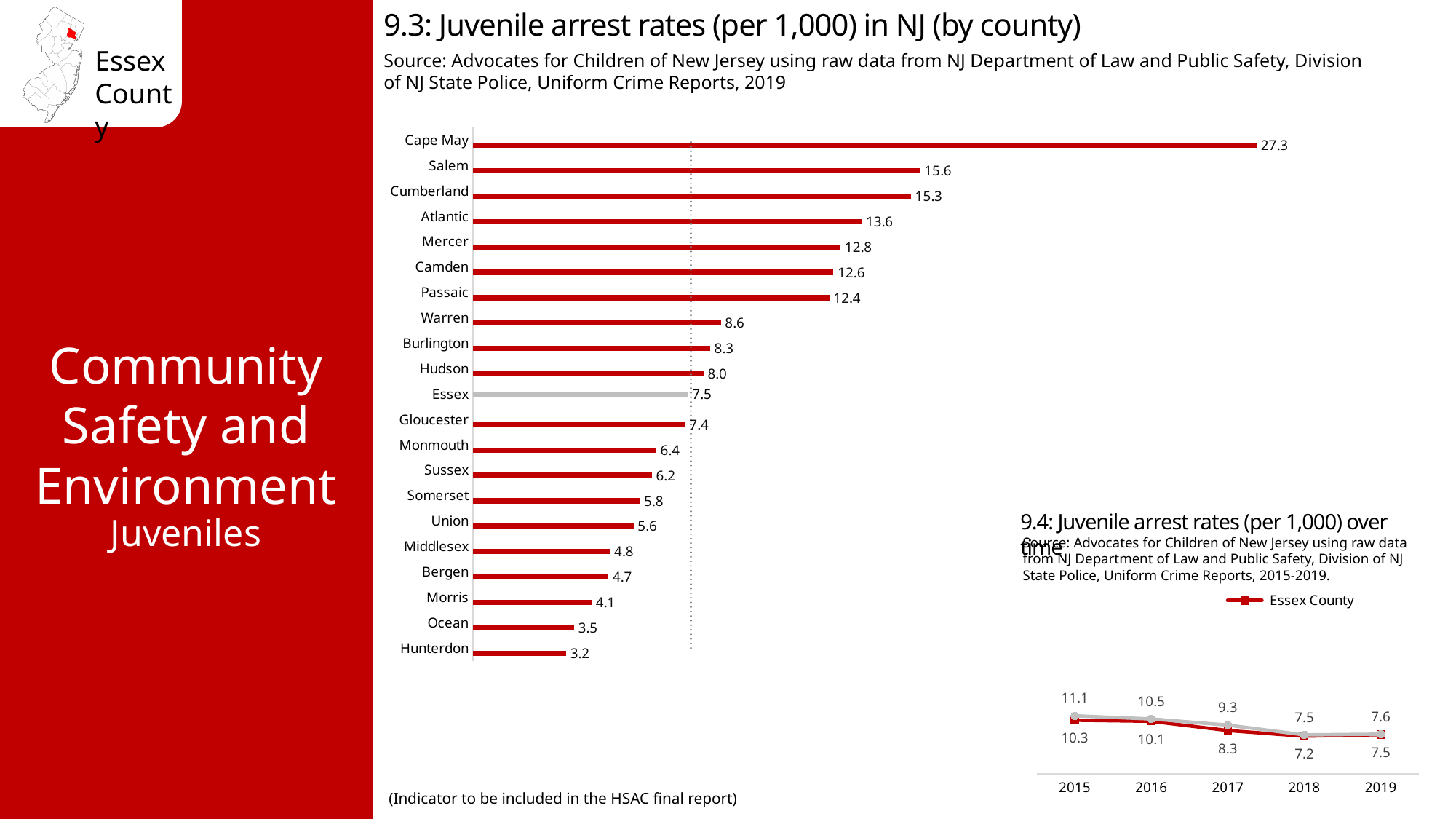
In chart 9.3, which county has the lowest juvenile arrest rate? Hunterdon In chart 9.3, what is the difference between the rates for Cape May and Salem? 11.7 How many counties are shown in chart 9.3? 21 What type of chart is chart 9.3? Bar chart In chart 9.3, which county's bar is coloured grey instead of red? Essex In chart 9.4, by how much did the Essex County rate decrease from 2015 to 2019? 2.8 In chart 9.3, what is the juvenile arrest rate for Essex? 7.5 In chart 9.3, what is the juvenile arrest rate for Cape May? 27.3 In chart 9.3, which has a higher juvenile arrest rate, Mercer or Camden? Mercer In chart 9.3, which county has the highest juvenile arrest rate? Cape May In chart 9.4, does the Essex County juvenile arrest rate generally rise or fall from 2015 to 2019? Fall In chart 9.4, what was the Essex County juvenile arrest rate in 2015? 10.3